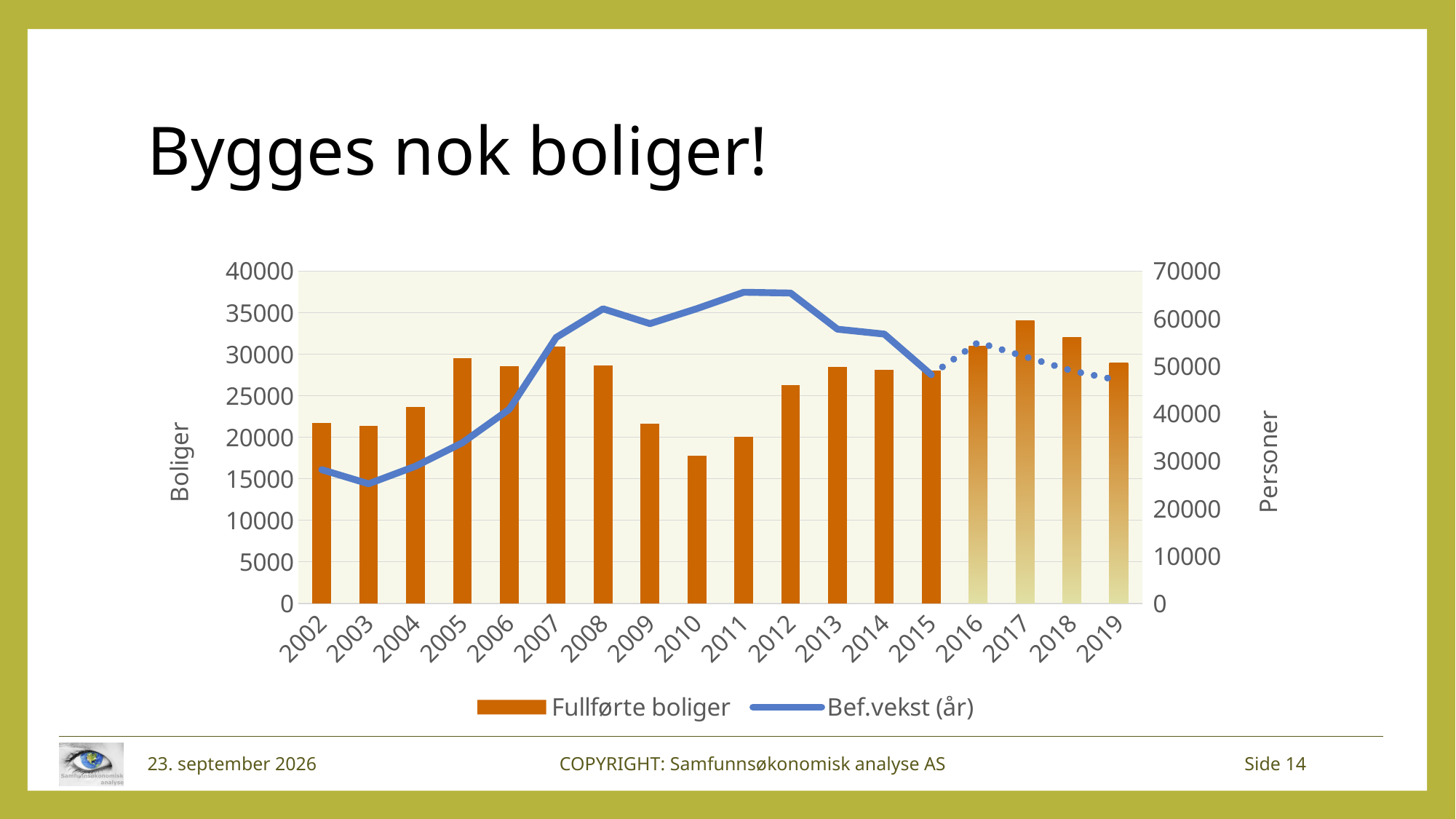
Is the Bef.vekst (år) value for 2011 greater or less than 60000 on the right axis? greater In which year is the Fullførte boliger bar the lowest? 2010 Which year has the larger Fullførte boliger bar, 2007 or 2010? 2007 Is the Fullførte boliger value for 2010 greater or less than 20000? less In which year is the Fullførte boliger bar the highest? 2017 What kind of chart is shown on the slide? A combination bar and line chart Does the Bef.vekst (år) line rise or fall from 2012 to 2015? It falls What is the label of the left vertical axis? Boliger How many years are shown along the x axis? 18 In which year is the Bef.vekst (år) line at its lowest point? 2003 Is the Fullførte boliger value for 2017 greater or less than 30000? greater How many series does the legend list? 2